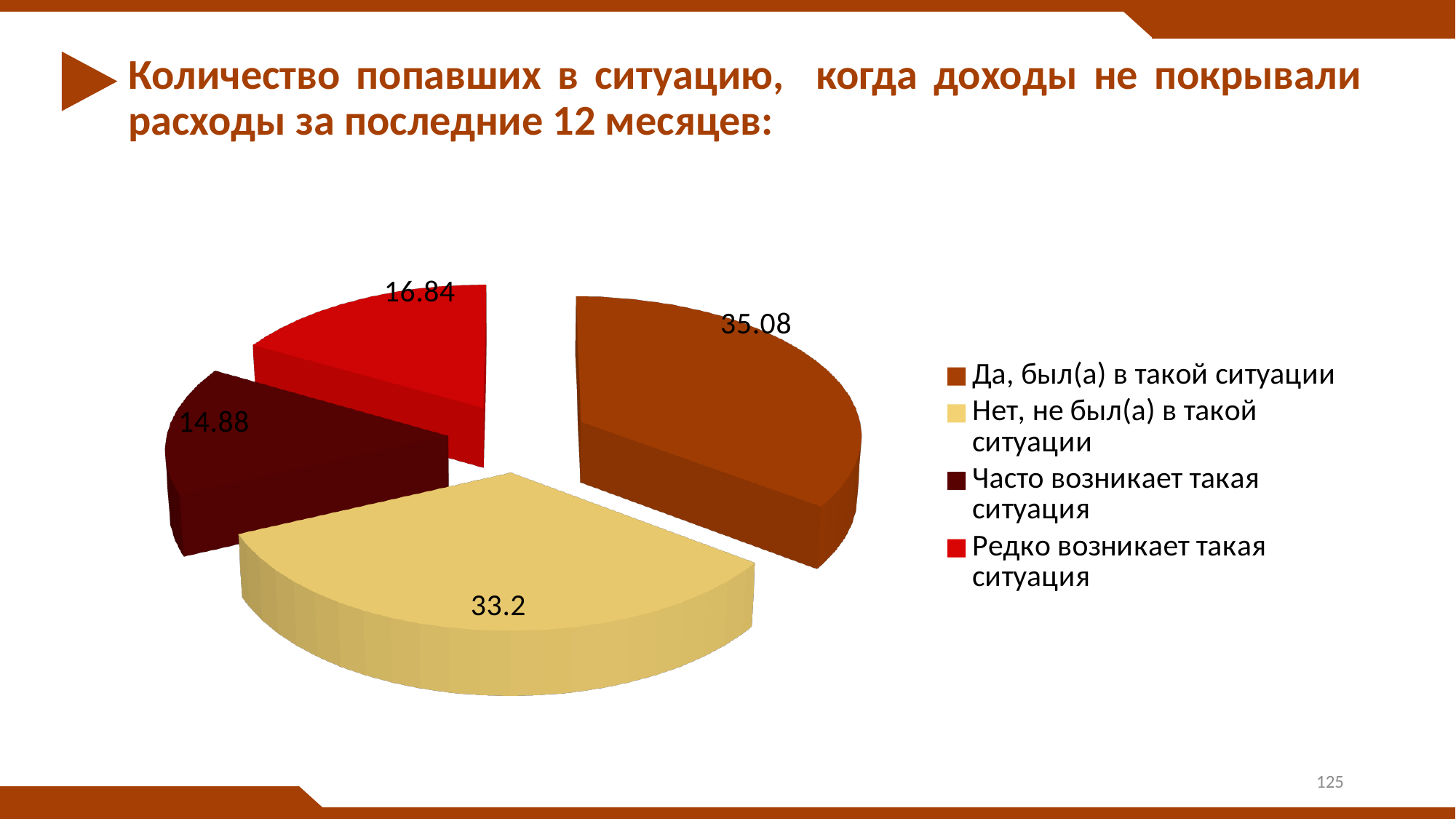
What is the value for "Редко возникает такая ситуация"? 16.84 Which is larger: the value for "Редко возникает такая ситуация" or for "Часто возникает такая ситуация"? Редко возникает такая ситуация What is the difference between the values for "Редко возникает такая ситуация" and "Часто возникает такая ситуация"? 1.96 Which category has the largest slice? Да, был(а) в такой ситуации What kind of chart is shown on the slide? pie chart What is the difference between the values for "Да, был(а) в такой ситуации" and "Нет, не был(а) в такой ситуации"? 1.88 What is the value for "Да, был(а) в такой ситуации"? 35.08 How many slices does the pie chart have? 4 What colour is the slice for "Нет, не был(а) в такой ситуации"? yellow What is the value for "Часто возникает такая ситуация"? 14.88 What is the value for "Нет, не был(а) в такой ситуации"? 33.2 Which category has the smallest slice? Часто возникает такая ситуация